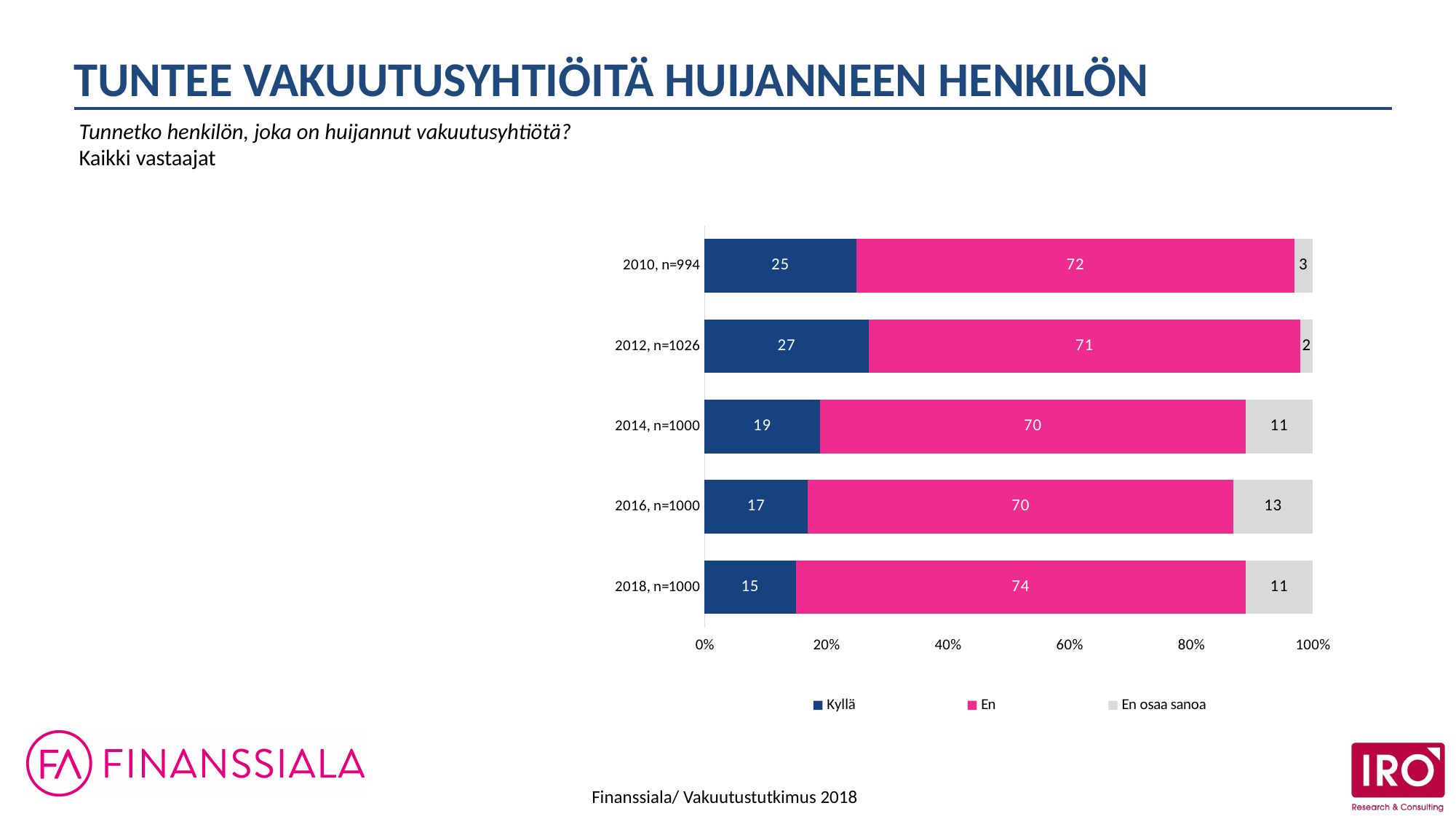
What is the difference between the Kyllä values for 2012, n=1026 and 2018, n=1000? 12 What is the total of the stacked bar for 2010, n=994? 100 Does the Kyllä value rise or fall from 2012, n=1026 to 2018, n=1000? Fall What is the value for En osaa sanoa in 2016, n=1000? 13 Which is larger, the En osaa sanoa value for 2014, n=1000 or for 2016, n=1000? 2016, n=1000 What is the value for En in 2018, n=1000? 74 What is the value for Kyllä in 2010, n=994? 25 Which category has the highest Kyllä value? 2012, n=1026 How many categories are shown on the chart? 5 What kind of chart is shown on the slide? Stacked bar chart How many series does the legend list? 3 Which category has the lowest Kyllä value? 2018, n=1000